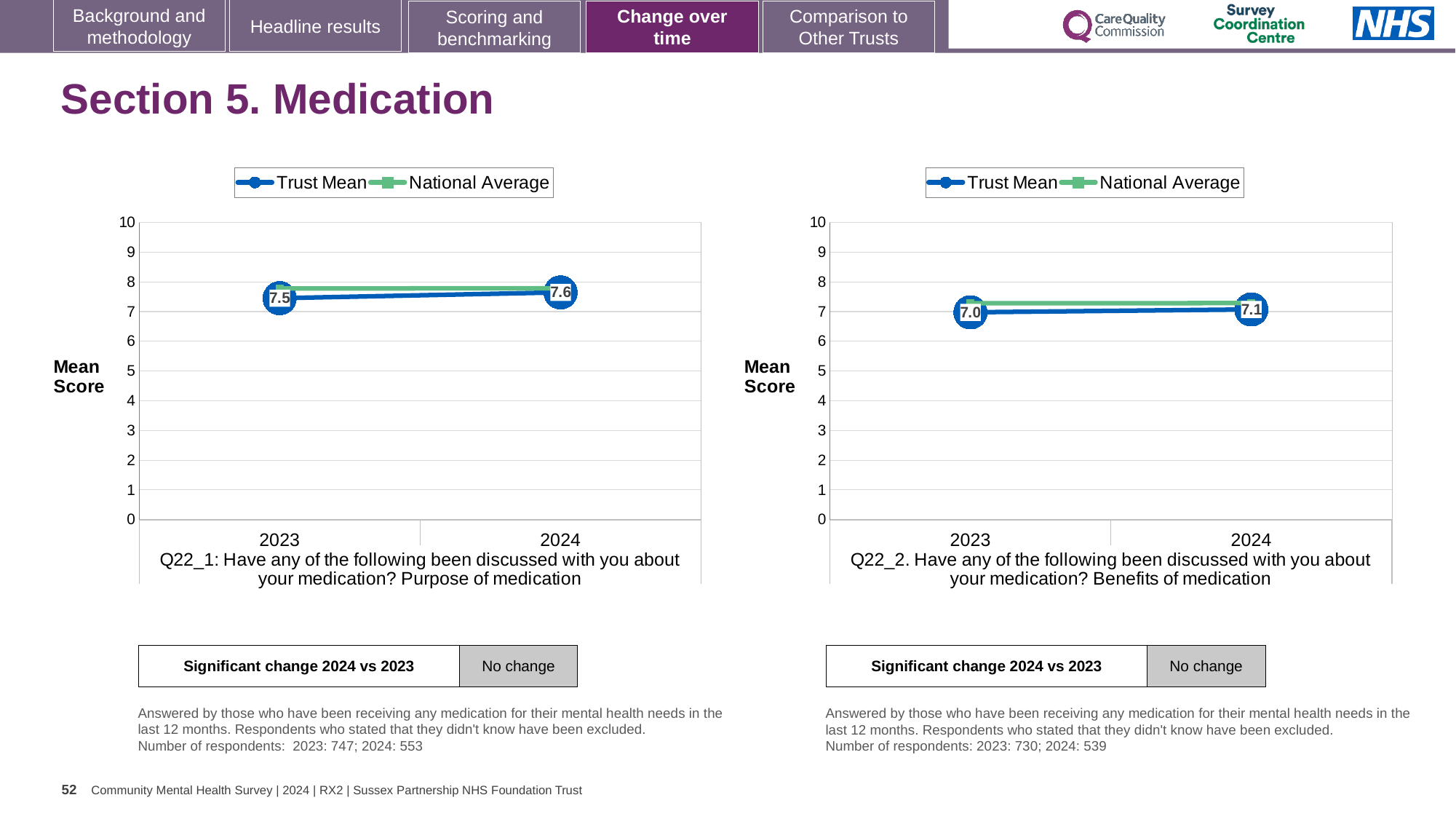
How many series does the legend of the right chart (Q22_2: Benefits of medication) list? 2 In the left chart (Q22_1: Purpose of medication), what is the Trust Mean score for 2024? 7.6 In the right chart (Q22_2: Benefits of medication), which is larger in 2023, the Trust Mean or the National Average? National Average What kind of chart is the left chart (Q22_1: Purpose of medication)? line chart In the right chart (Q22_2: Benefits of medication), what is the Trust Mean score for 2023? 7.0 How many years are plotted on the x axis of the left chart (Q22_1: Purpose of medication)? 2 In the left chart (Q22_1: Purpose of medication), what is the Trust Mean score for 2023? 7.5 In the left chart (Q22_1: Purpose of medication), is the National Average value for 2023 greater or less than 7? greater In the left chart (Q22_1: Purpose of medication), by how much did the Trust Mean change from 2023 to 2024? 0.1 What is the label on the y axis of the right chart (Q22_2: Benefits of medication)? Mean Score In the right chart (Q22_2: Benefits of medication), does the Trust Mean rise or fall from 2023 to 2024? rise In the right chart (Q22_2: Benefits of medication), what is the Trust Mean score for 2024? 7.1